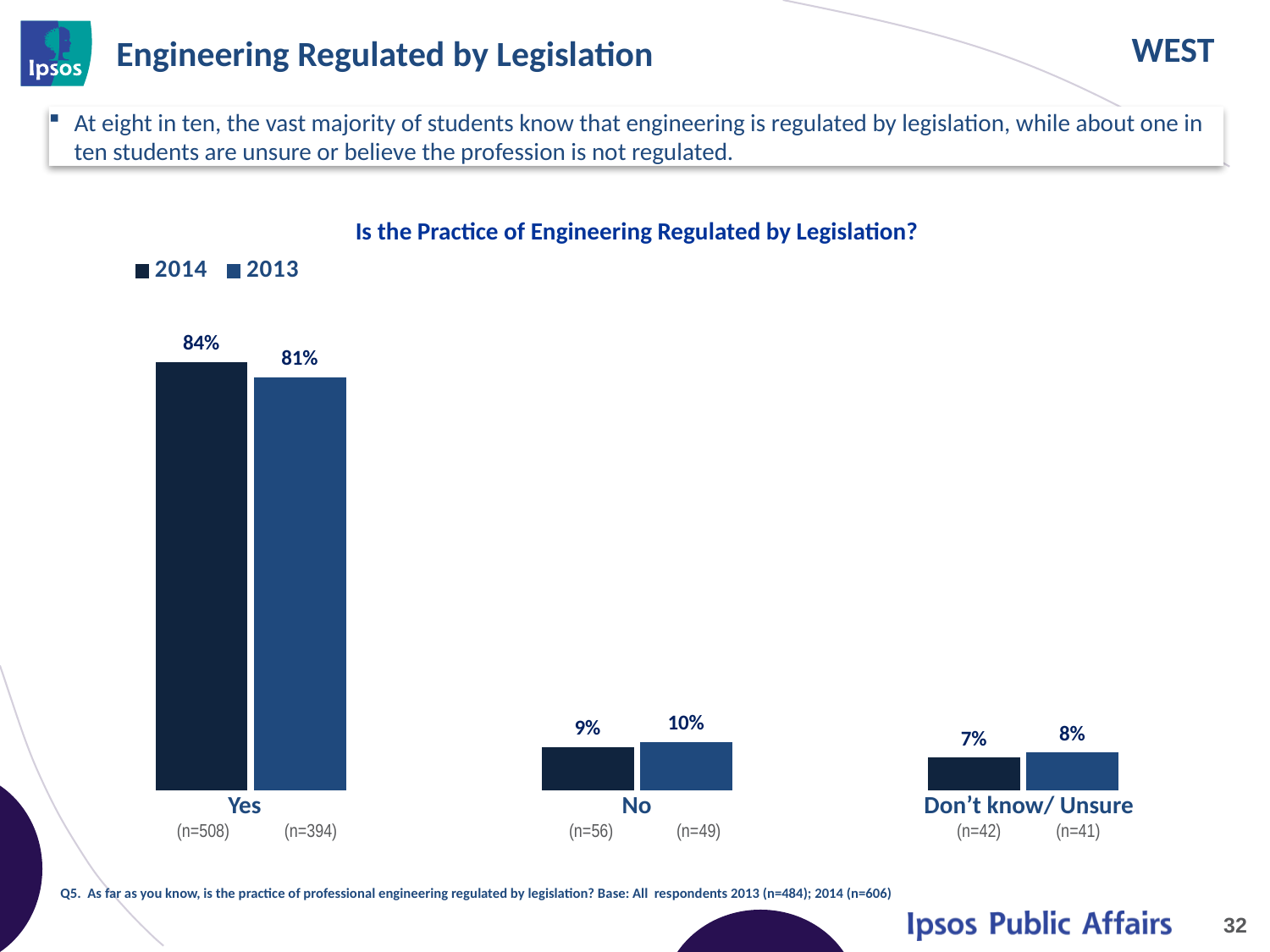
Which response category has the highest value in 2014? Yes What percentage of students answered "Yes" in 2014? 84% How many response categories are shown on the x axis? 3 What is the difference between the 2014 and 2013 values for "Yes"? 3 percentage points What is the title of the chart? Is the Practice of Engineering Regulated by Legislation? For "No", which year has the larger value, 2014 or 2013? 2013 What type of chart is shown on the slide? Bar chart What is the 2014 value for "Don't know/ Unsure"? 7% Which response category has the lowest value in 2013? Don't know/ Unsure What is the 2013 value for "No"? 10% What percentage of students answered "Yes" in 2013? 81% How many series does the legend list? 2